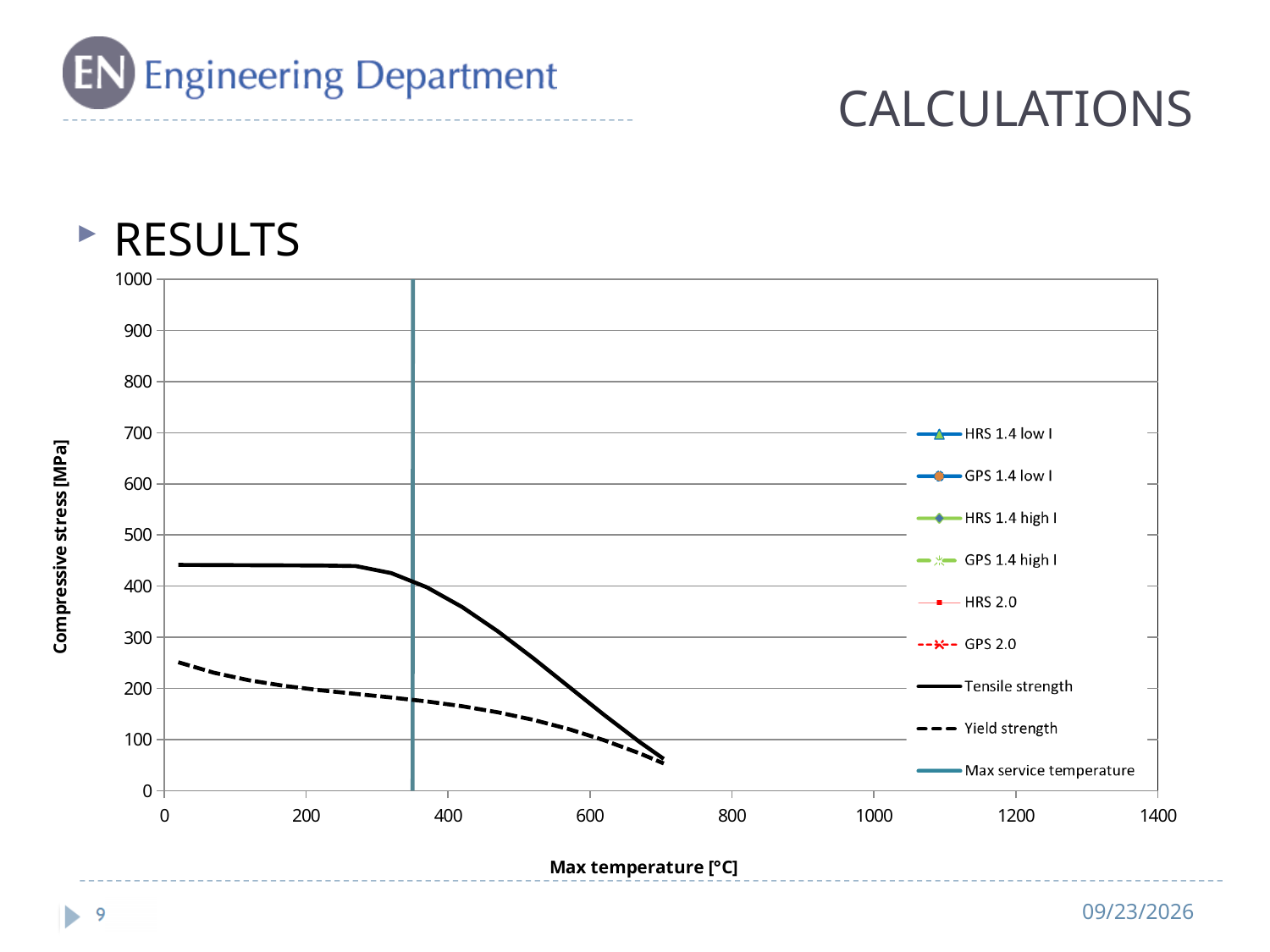
Is the Tensile strength value at 200 °C greater or less than 400? greater Does the Tensile strength curve rise or fall as the max temperature increases? fall Is the Yield strength value at 400 °C greater or less than 200? less Is the Max service temperature line positioned at a temperature greater or less than 300 °C? greater How many series does the chart legend list? 9 What is the highest value shown on the y axis of the chart? 1000 What is the label of the y axis of the chart? Compressive stress [MPa] What kind of chart is shown on the slide? line chart Does the Yield strength curve rise or fall as the max temperature increases? fall At 400 °C, which is larger: Tensile strength or Yield strength? Tensile strength What is the label of the x axis of the chart? Max temperature [°C]